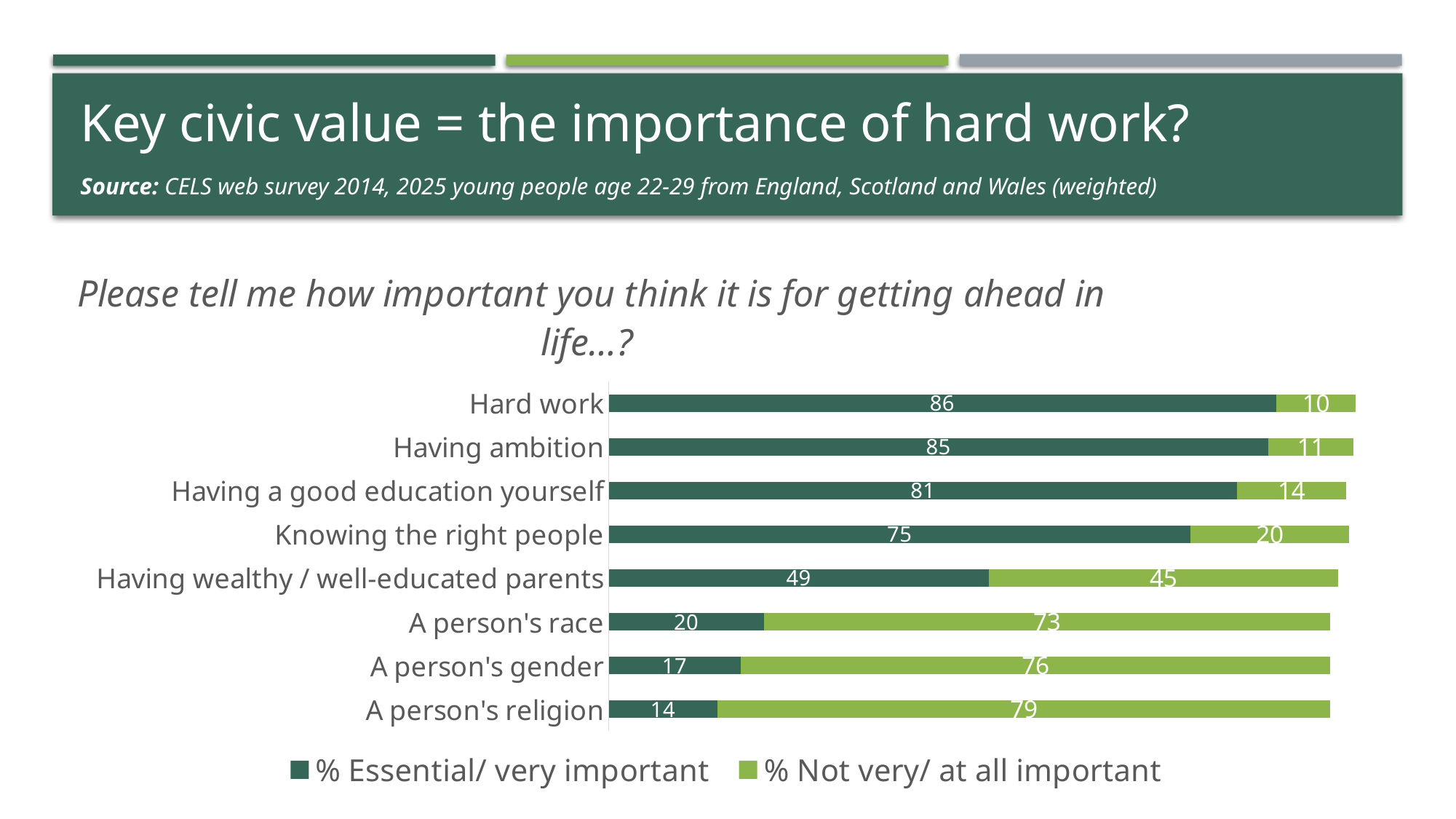
What kind of chart is shown on the slide? Stacked bar chart Which category has the highest value for '% Essential/ very important'? Hard work What is the value for '% Not very/ at all important' for A person's religion? 79 What is the title of the chart? Please tell me how important you think it is for getting ahead in life...? What is the total of the stacked bar for Having a good education yourself? 95 How many categories are shown on the chart? 8 How many series does the legend list? 2 What is the value for '% Essential/ very important' for Hard work? 86 What is the value for '% Essential/ very important' for Having wealthy / well-educated parents? 49 What is the difference between the '% Not very/ at all important' values for A person's race and Knowing the right people? 53 Which is larger: the '% Essential/ very important' value for Knowing the right people or for A person's gender? Knowing the right people Which category has the lowest value for '% Not very/ at all important'? Hard work